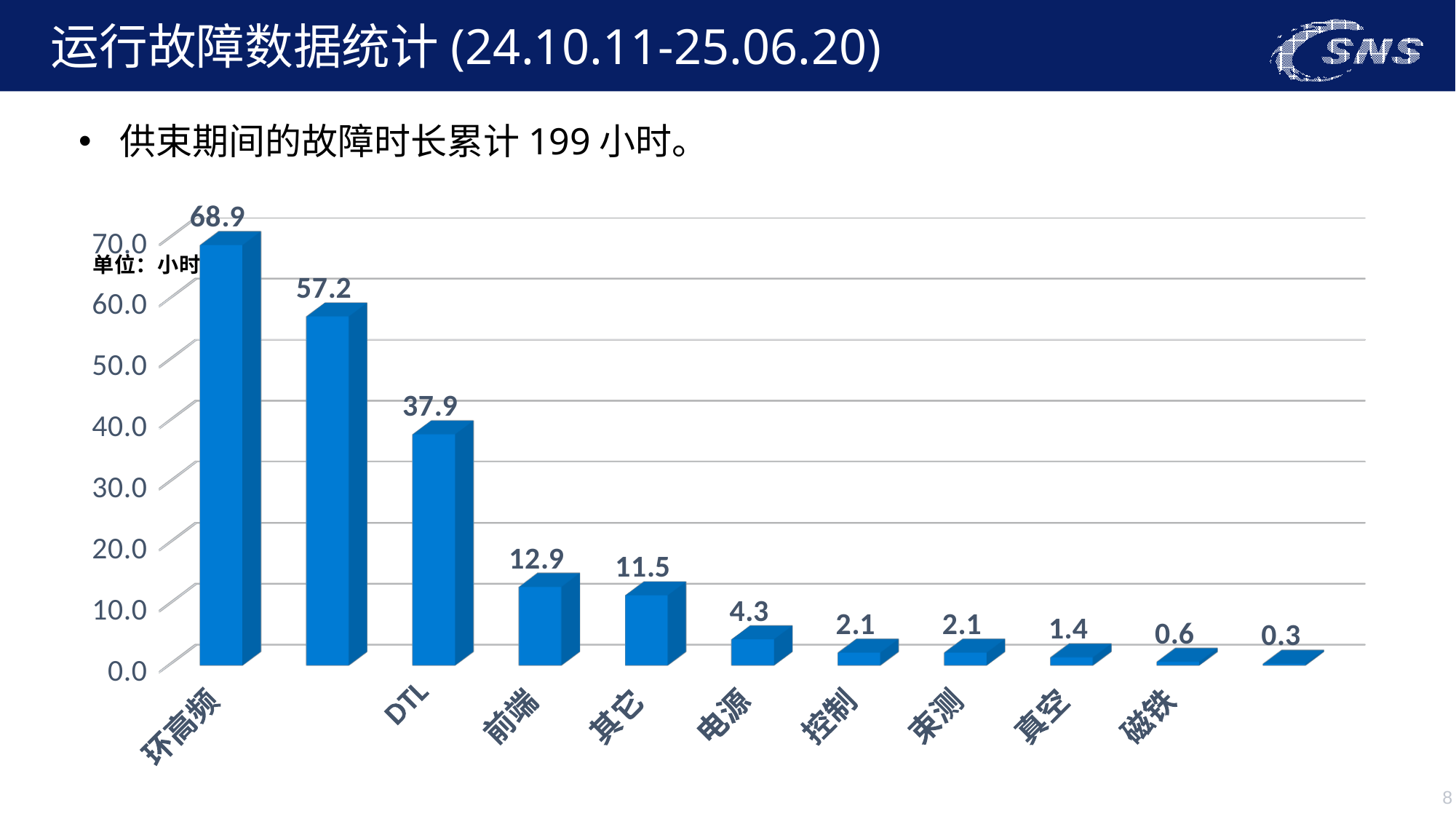
What is the value for 磁铁? 0.6 What is the value for 环高频? 68.9 Which category has the highest fault duration? 环高频 How many bars are plotted in the chart? 11 What is the value for 前端? 12.9 What is the lowest value shown in the chart? 0.3 What is the value for 电源? 4.3 What is the difference between the two tallest bars (68.9 and 57.2)? 11.7 What is the highest value shown in the chart? 68.9 What type of chart is shown on the slide? bar chart What unit is stated for the values in the chart? 小时 Do the values rise or fall from left to right along the x axis? fall